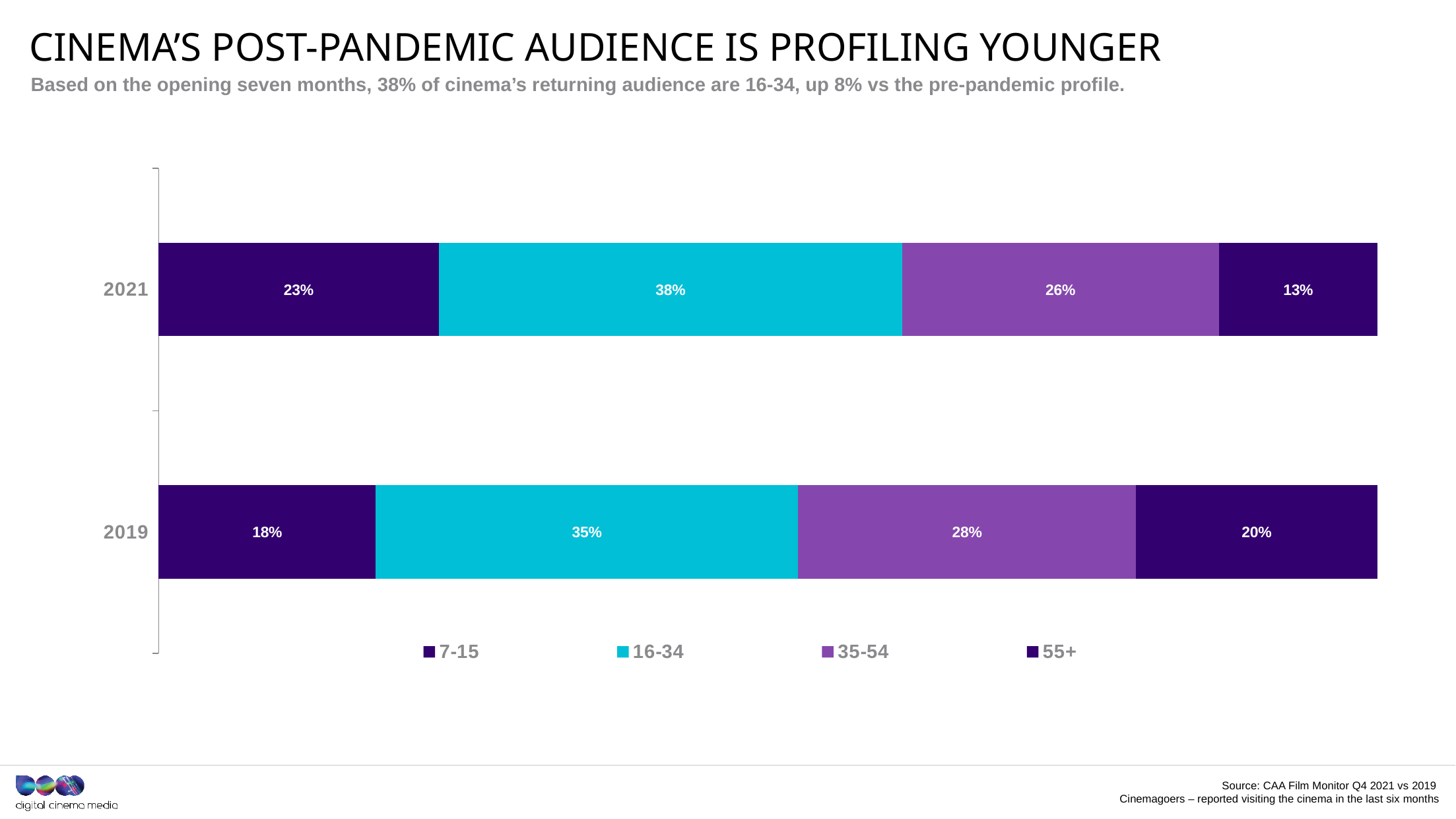
How many age groups does the legend list? 4 Which age group has the smallest share of the 2021 audience? 55+ How many years are shown on the chart? 2 Which age group has the smallest share of the 2019 audience? 7-15 By how many percentage points did the 16-34 share change from 2019 to 2021? 3 percentage points What share of the 2019 audience is aged 55+? 20% What kind of chart is shown on the slide? Stacked bar chart Which year has the larger share of 55+ cinemagoers, 2019 or 2021? 2019 Which age group has the largest share of the 2021 audience? 16-34 What is the value for the 35-54 age group in 2019? 28% What is the value for the 7-15 age group in 2021? 23% What share of the 2021 audience is aged 16-34? 38%